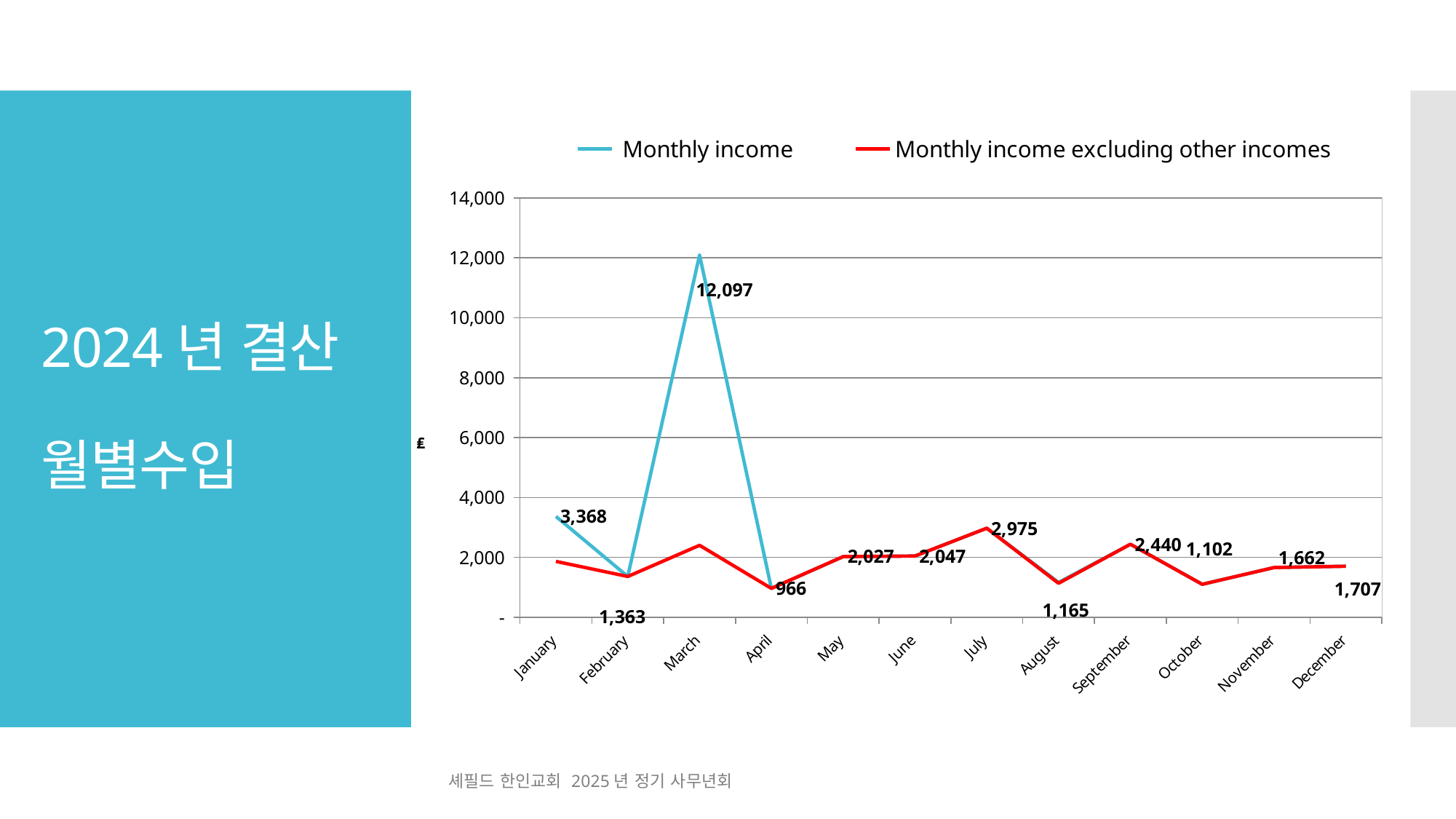
Is the Monthly income for July larger or smaller than the Monthly income for December? larger What is the Monthly income value for September? 2,440 What is the Monthly income value for April? 966 What is the difference between the Monthly income for July and for August? 1,810 Is the value of Monthly income excluding other incomes for March greater or less than 4,000? less Which month has the highest Monthly income? March What kind of chart is shown on the slide? line chart How many series does the legend list? 2 Which month has the lowest Monthly income? April What is the Monthly income value for March? 12,097 What is the Monthly income value for January? 3,368 How many months are plotted along the x axis? 12